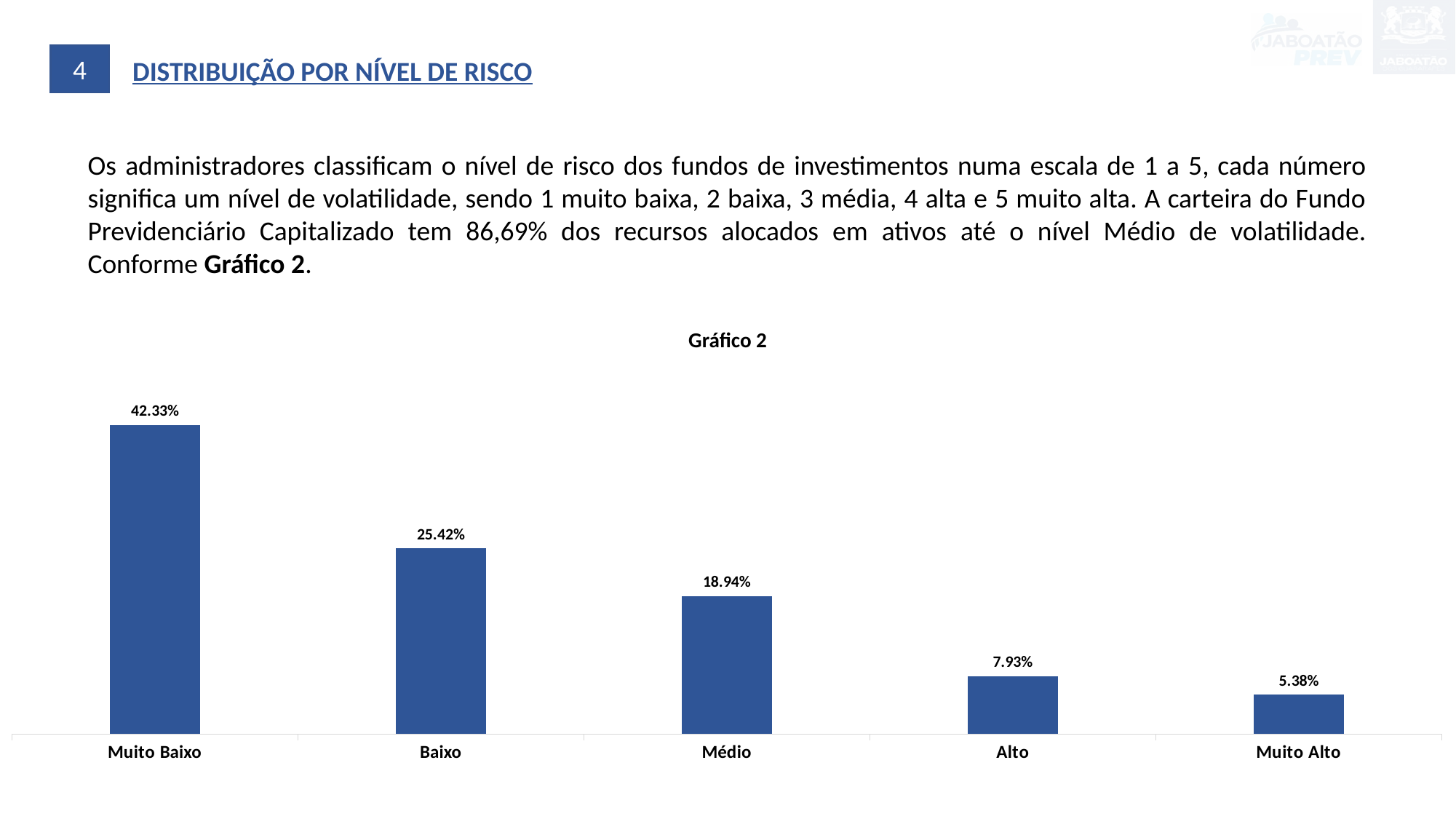
What is the difference between the values for Muito Baixo and Baixo? 16.91% What is the value for Médio? 18.94% What is the value for Alto? 7.93% Which category has the lowest value? Muito Alto Which is larger, the value for Médio or the value for Alto? Médio Do the values rise or fall from left to right along the x axis? Fall What is the value for Muito Alto? 5.38% How many categories are shown on the x axis? 5 What is the value for Baixo? 25.42% Which category has the highest value? Muito Baixo What kind of chart is shown? Bar chart What is the value for Muito Baixo? 42.33%